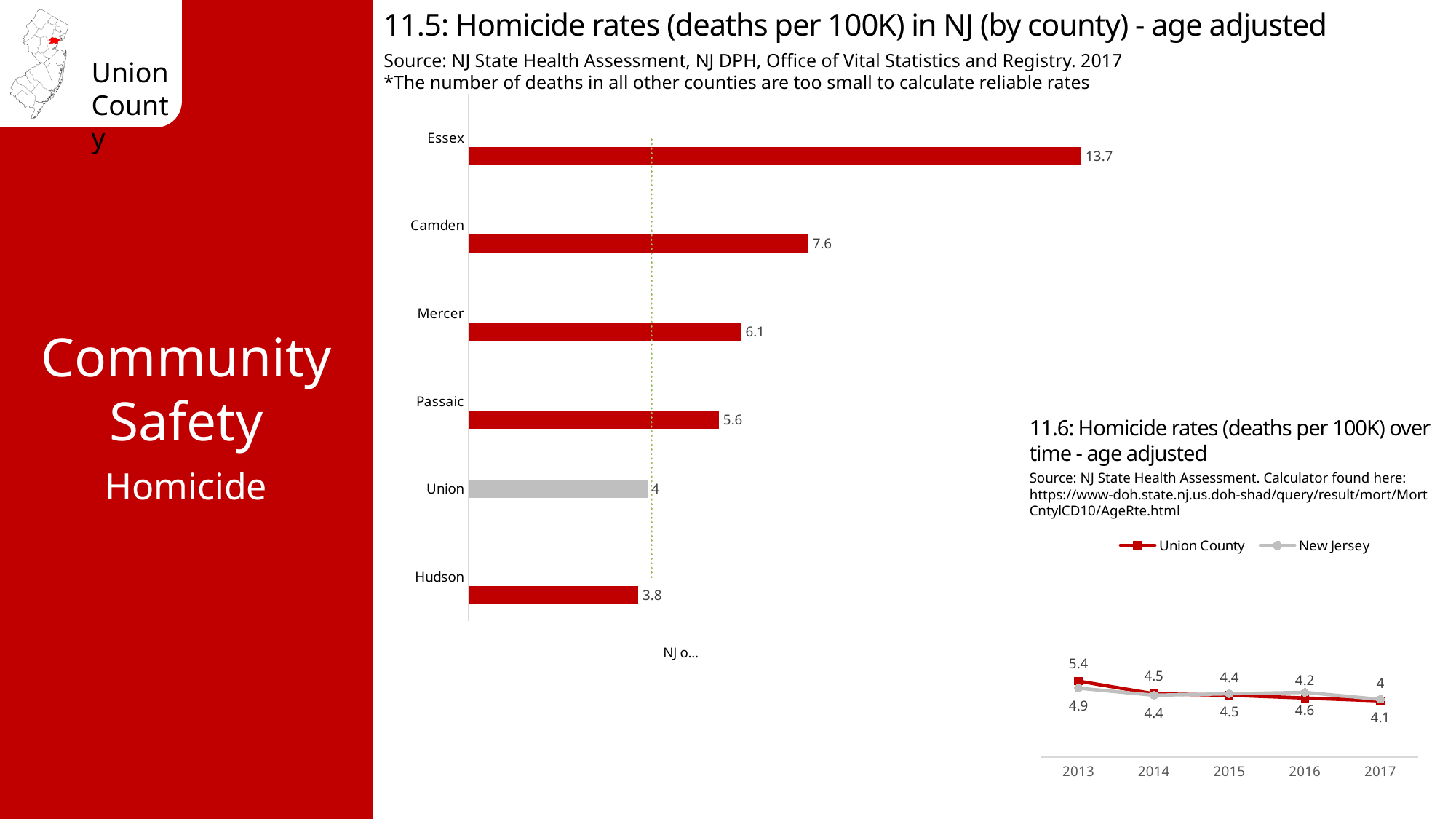
In the chart '11.5: Homicide rates (deaths per 100K) in NJ (by county) - age adjusted', what is the homicide rate for Essex? 13.7 In the chart '11.6: Homicide rates (deaths per 100K) over time - age adjusted', what was the New Jersey rate in 2016? 4.6 In the chart '11.5: Homicide rates (deaths per 100K) in NJ (by county) - age adjusted', what is the difference between the rates for Camden and Mercer? 1.5 In the chart '11.6: Homicide rates (deaths per 100K) over time - age adjusted', what was the Union County rate in 2013? 5.4 In the chart '11.5: Homicide rates (deaths per 100K) in NJ (by county) - age adjusted', which county's bar is shown in grey instead of red? Union In the chart '11.6: Homicide rates (deaths per 100K) over time - age adjusted', how many series does the legend list? 2 In the chart '11.5: Homicide rates (deaths per 100K) in NJ (by county) - age adjusted', which county has the lowest homicide rate? Hudson In the chart '11.6: Homicide rates (deaths per 100K) over time - age adjusted', does the Union County rate rise or fall from 2013 to 2017? Fall What kind of chart is '11.5: Homicide rates (deaths per 100K) in NJ (by county) - age adjusted'? Bar chart In the chart '11.5: Homicide rates (deaths per 100K) in NJ (by county) - age adjusted', which county has the highest homicide rate? Essex In the chart '11.5: Homicide rates (deaths per 100K) in NJ (by county) - age adjusted', how many counties are shown? 6 In the chart '11.5: Homicide rates (deaths per 100K) in NJ (by county) - age adjusted', what is the homicide rate for Passaic? 5.6